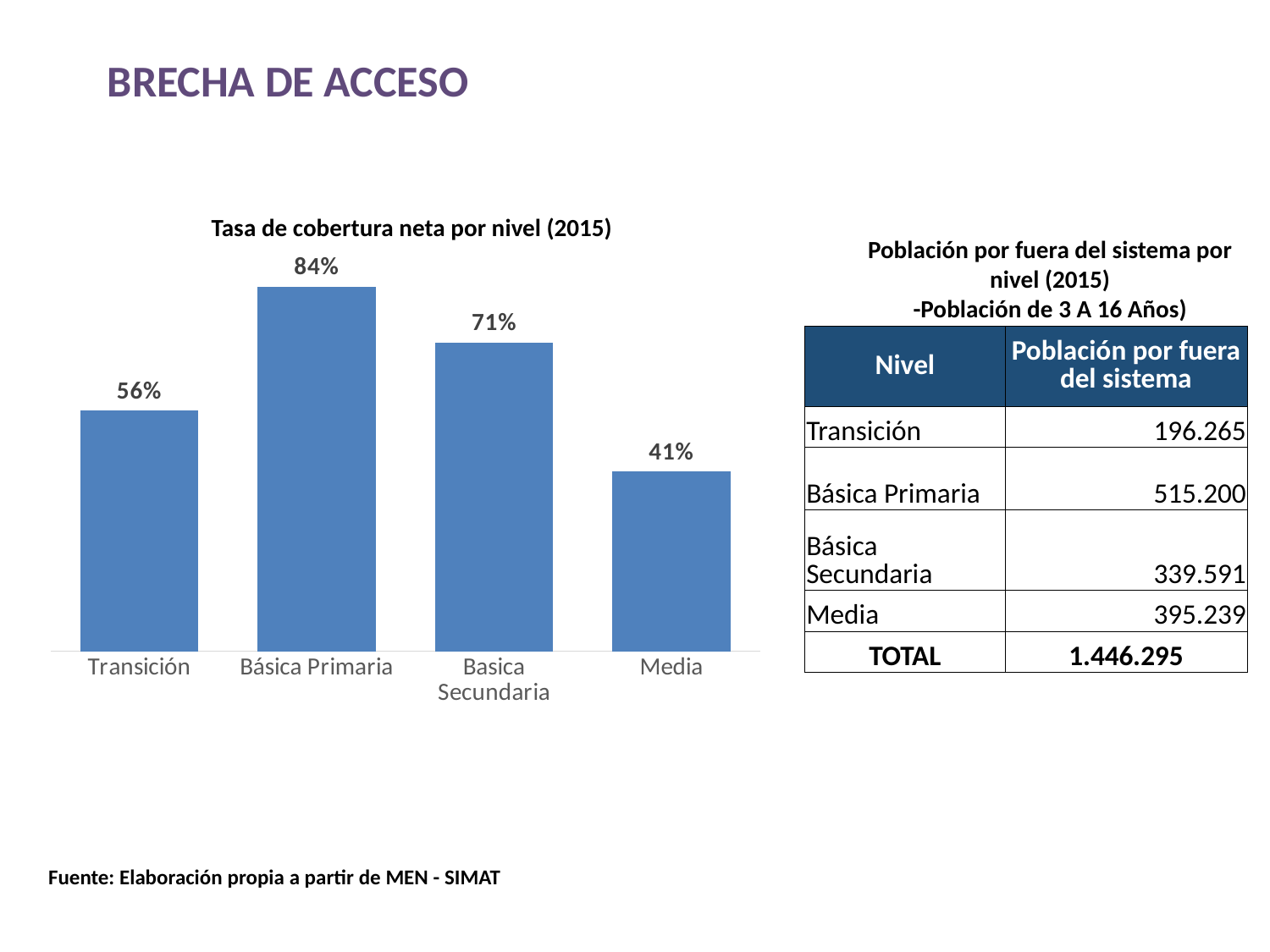
Which category has the highest value in the chart 'Tasa de cobertura neta por nivel (2015)'? Básica Primaria What is the value for Media in the chart 'Tasa de cobertura neta por nivel (2015)'? 41% How many categories are shown in the chart 'Tasa de cobertura neta por nivel (2015)'? 4 Which category has the lowest value in the chart 'Tasa de cobertura neta por nivel (2015)'? Media What is the value for Básica Primaria in the chart 'Tasa de cobertura neta por nivel (2015)'? 84% What is the title of the chart on the left of the slide? Tasa de cobertura neta por nivel (2015) What is the difference between the values for Básica Primaria and Media in the chart 'Tasa de cobertura neta por nivel (2015)'? 43% What is the value for Basica Secundaria in the chart 'Tasa de cobertura neta por nivel (2015)'? 71% What kind of chart is 'Tasa de cobertura neta por nivel (2015)'? Bar chart What is the difference between the values for Basica Secundaria and Transición in the chart 'Tasa de cobertura neta por nivel (2015)'? 15% What is the value for Transición in the chart 'Tasa de cobertura neta por nivel (2015)'? 56% In the chart 'Tasa de cobertura neta por nivel (2015)', which is larger: the value for Transición or the value for Media? Transición